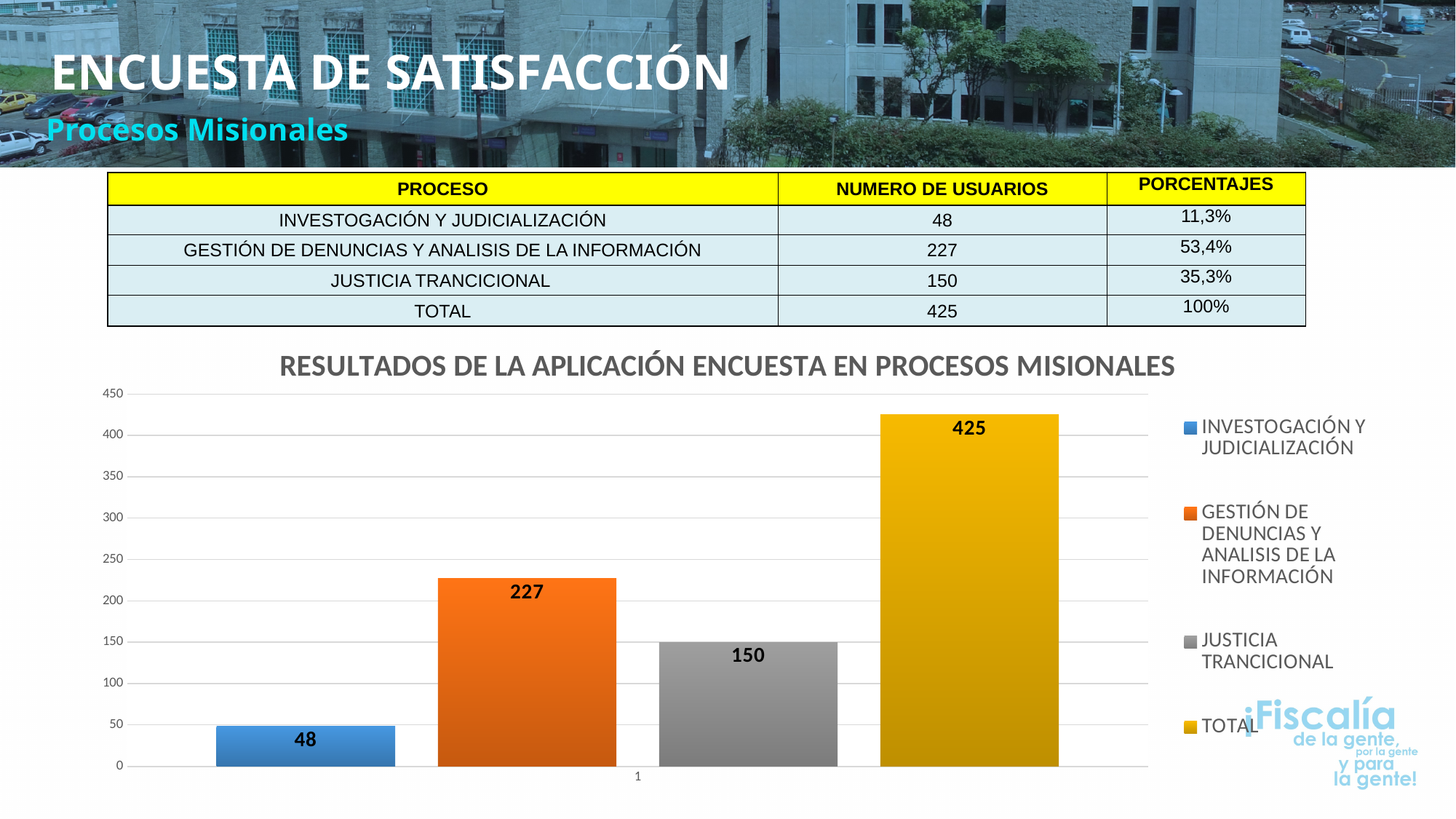
What is the value for JUSTICIA TRANCICIONAL in the chart? 150 Which series has the lowest value in the chart? INVESTOGACIÓN Y JUDICIALIZACIÓN What is the title of the chart? RESULTADOS DE LA APLICACIÓN ENCUESTA EN PROCESOS MISIONALES What is the value for INVESTOGACIÓN Y JUDICIALIZACIÓN in the chart? 48 What kind of chart is shown on the slide? bar chart What is the value for GESTIÓN DE DENUNCIAS Y ANALISIS DE LA INFORMACIÓN in the chart? 227 What is the difference between the values for GESTIÓN DE DENUNCIAS Y ANALISIS DE LA INFORMACIÓN and JUSTICIA TRANCICIONAL? 77 Excluding TOTAL, which series has the highest value in the chart? GESTIÓN DE DENUNCIAS Y ANALISIS DE LA INFORMACIÓN What is the value of the TOTAL bar in the chart? 425 How many series does the chart legend list? 4 Which is larger: the value for JUSTICIA TRANCICIONAL or the value for INVESTOGACIÓN Y JUDICIALIZACIÓN? JUSTICIA TRANCICIONAL Is the value for GESTIÓN DE DENUNCIAS Y ANALISIS DE LA INFORMACIÓN greater or less than 200? greater